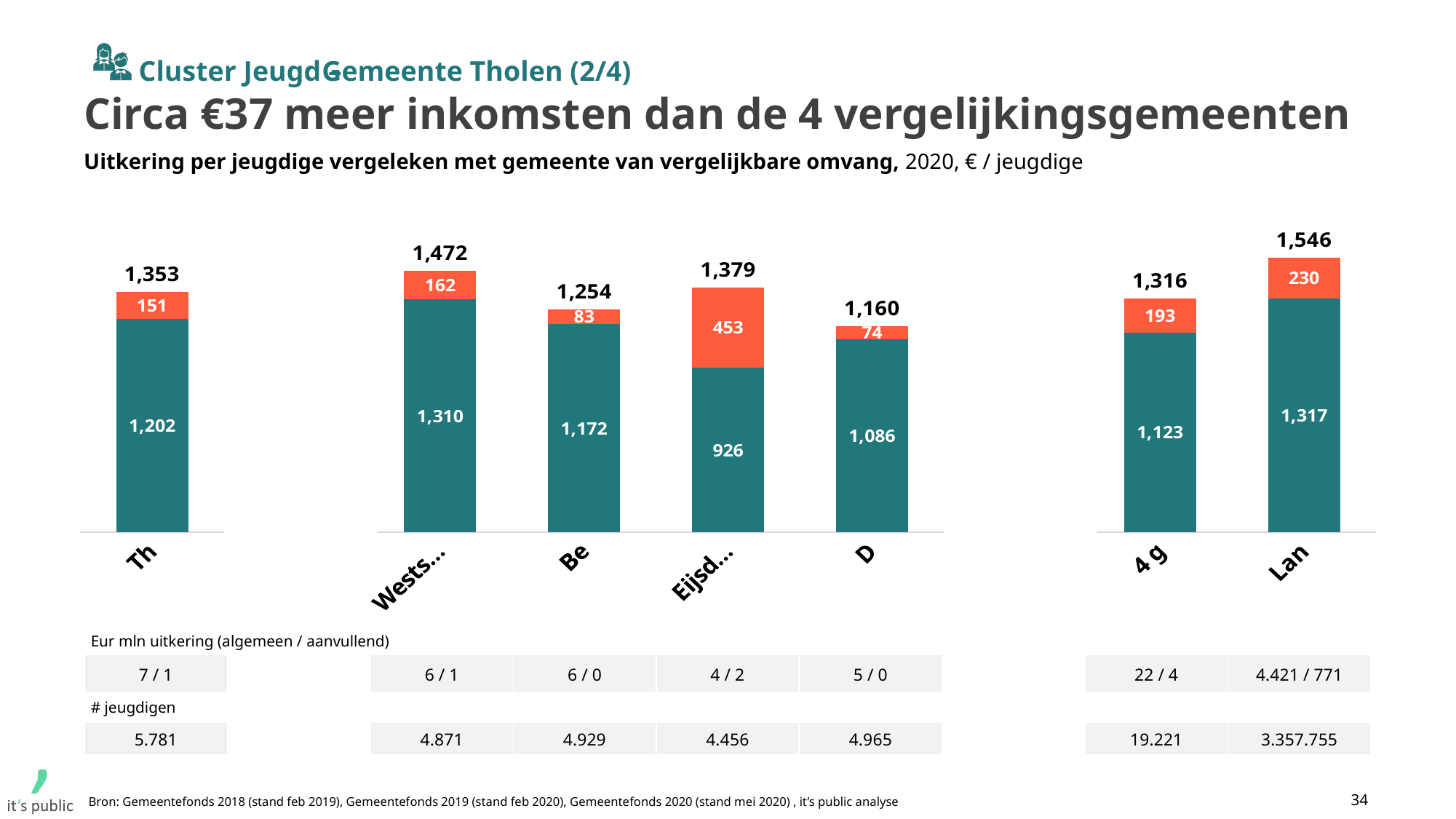
What kind of chart is shown on the slide? Stacked bar chart What is the total value printed above the bar for Th? 1,353 Which category has the lowest total value? D What is the difference between the total for Th and the total for 4 g? 37 Which has a larger total value, Be or D? Be Which category has the largest orange (top) segment? Eijsd… What is the total of the stacked bar for Wests…? 1,472 Which category has the highest total value? Lan What is the value of the teal (bottom) segment of the bar for Lan? 1,317 How many bars are plotted in the chart? 7 What is the value of the orange (top) segment of the bar for Eijsd…? 453 What unit is stated in the chart subtitle for the values? € / jeugdige